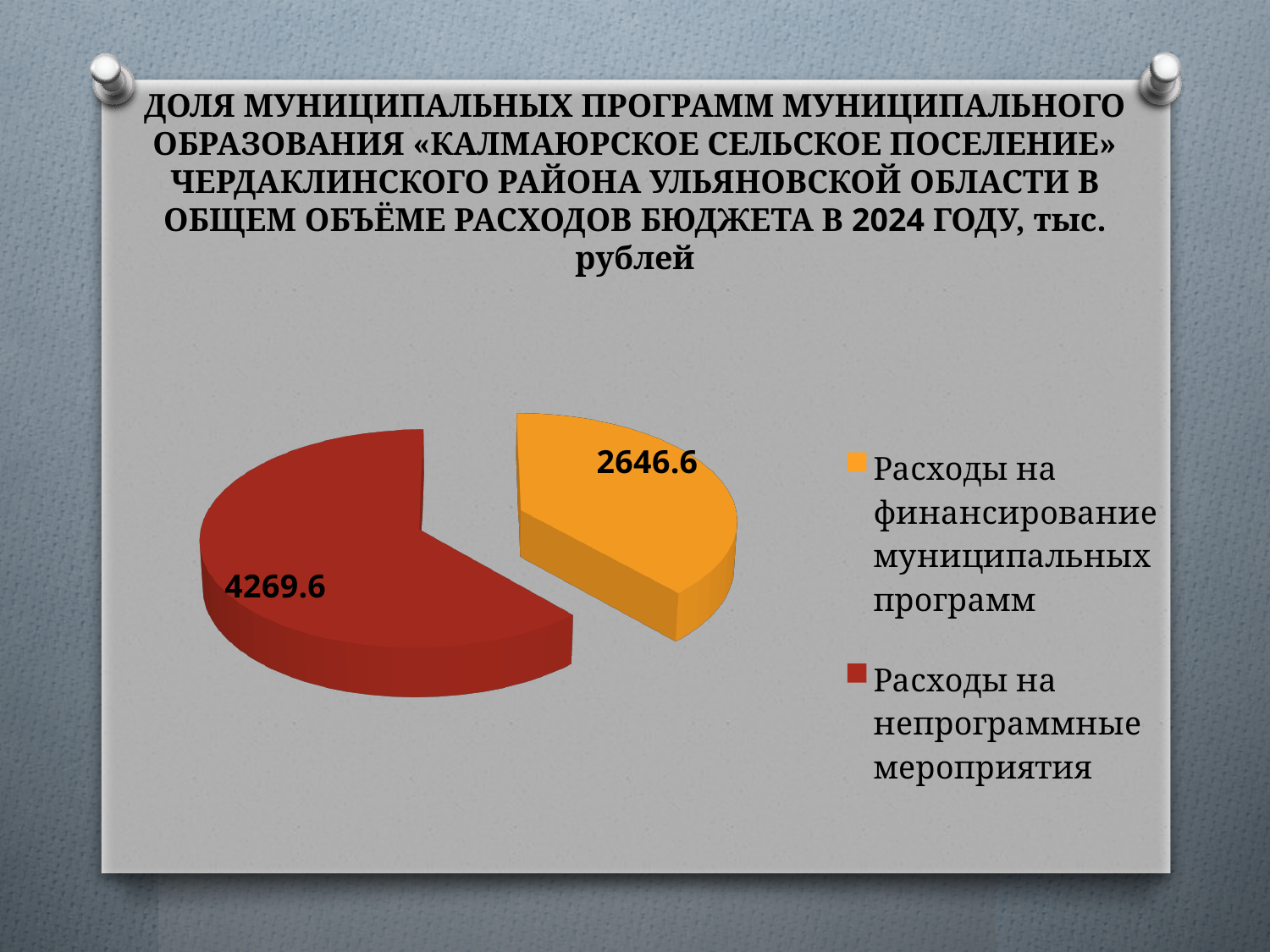
What share of the pie does «Расходы на финансирование муниципальных программ» represent, to the nearest whole percent? 38% What is the value for «Расходы на финансирование муниципальных программ»? 2646.6 What is the difference between the value for «Расходы на непрограммные мероприятия» and the value for «Расходы на финансирование муниципальных программ»? 1623.0 What kind of chart is shown on the slide? Pie chart Which is larger: «Расходы на финансирование муниципальных программ» or «Расходы на непрограммные мероприятия»? Расходы на непрограммные мероприятия How many slices does the pie chart have? 2 How many entries does the legend list? 2 What is the value for «Расходы на непрограммные мероприятия»? 4269.6 Which category has the largest slice of the pie? Расходы на непрограммные мероприятия What is the total of the two slices in the pie chart? 6916.2 What colour is the slice for «Расходы на непрограммные мероприятия»? Red Which category has the smallest slice of the pie? Расходы на финансирование муниципальных программ